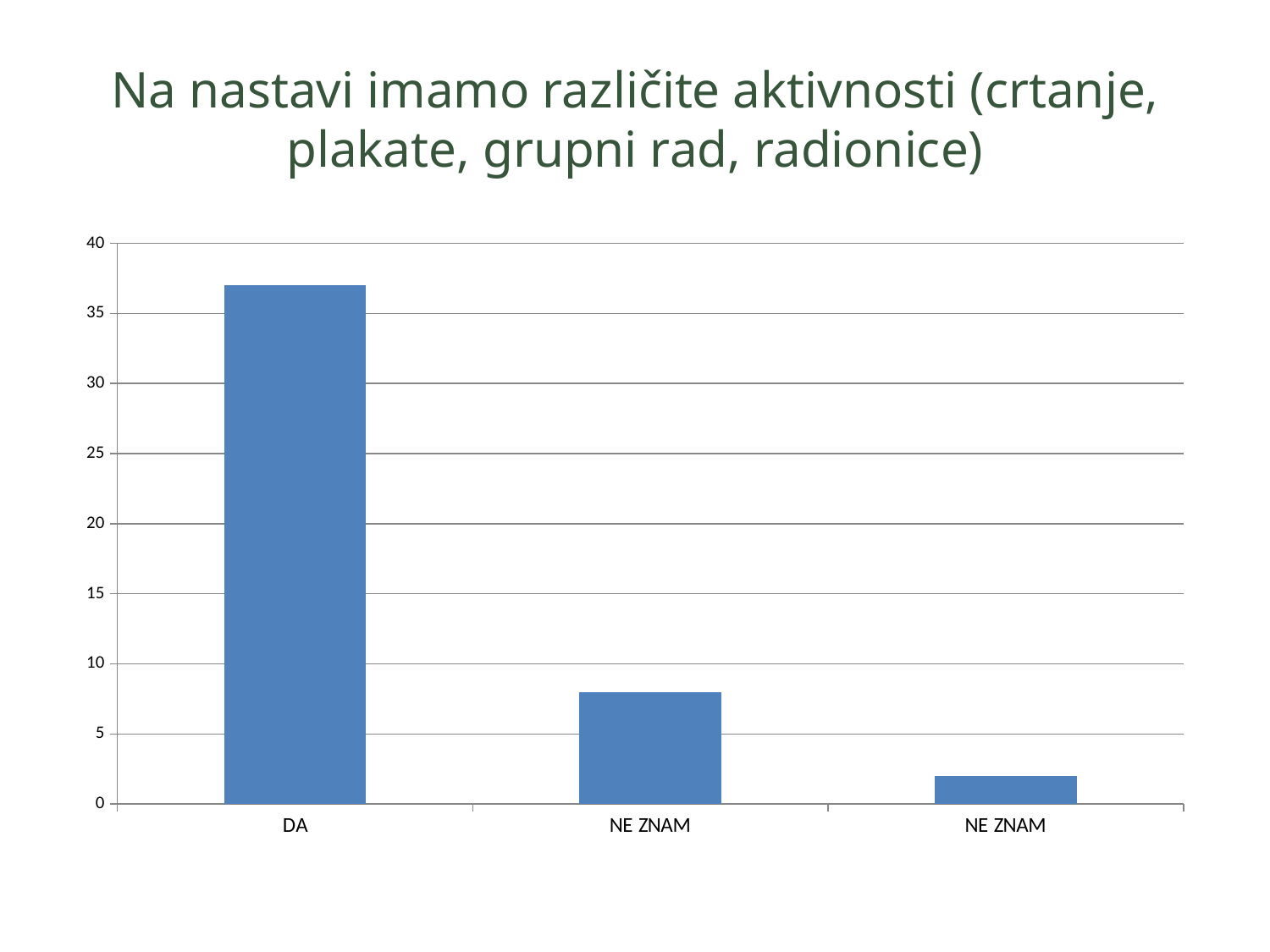
Which category has the highest bar? DA How many bars does the chart have? 3 Which is larger, the value for DA or the value of the second bar? DA What kind of chart is shown on the slide? bar chart Do the bar values rise or fall from left to right? fall Is the value for DA greater or less than 35? greater Which is larger, the second bar or the third bar? the second bar What is the title of the slide? Na nastavi imamo različite aktivnosti (crtanje, plakate, grupni rad, radionice) Is the value of the second bar (the first NE ZNAM) greater or less than 10? less Is the value of the third bar (the rightmost NE ZNAM) greater or less than 5? less